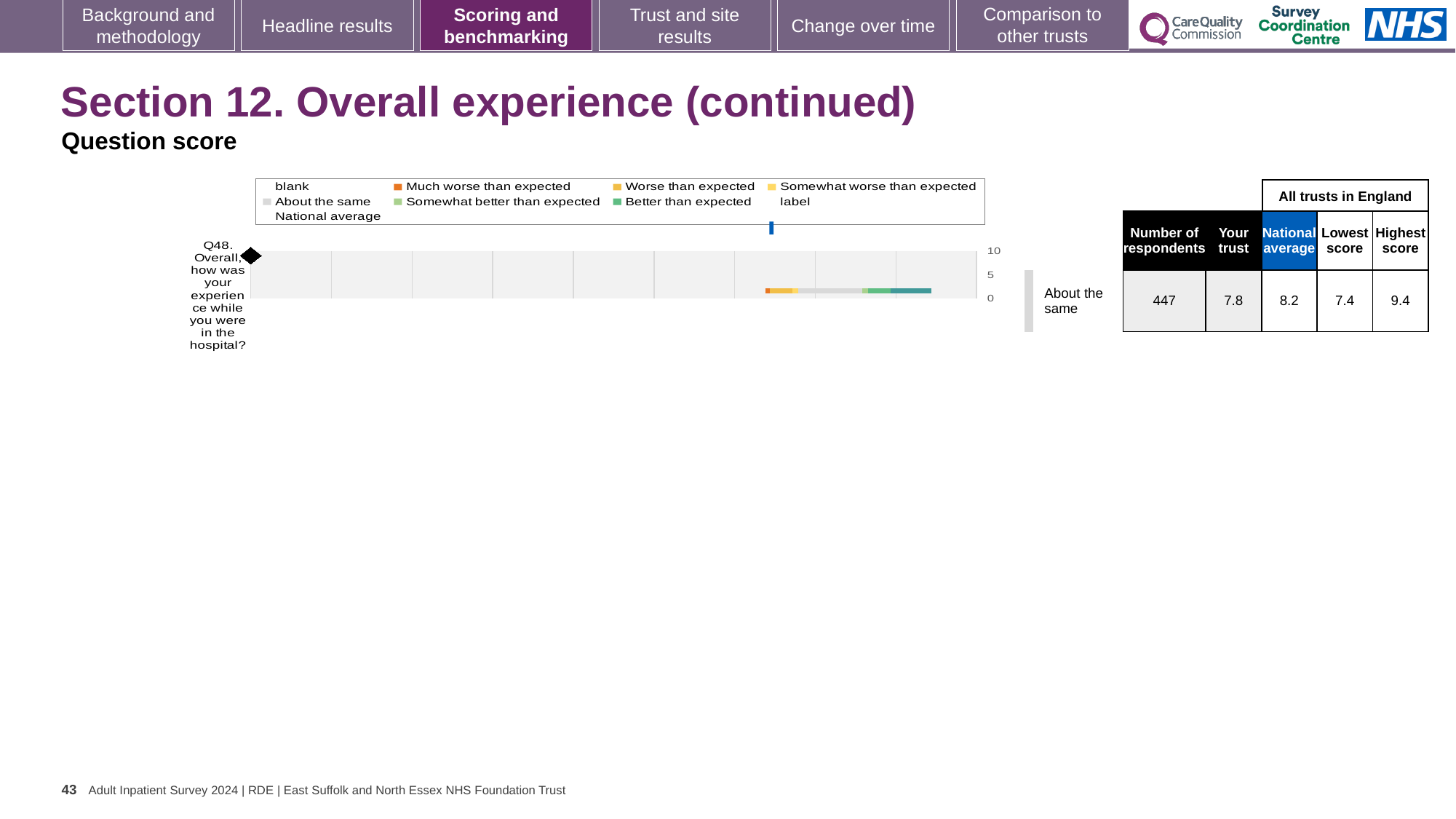
What is the lowest score among all trusts in England for Q48? 7.4 How many respondents answered Q48? 447 Which question is plotted on the chart? Q48. Overall, how was your experience while you were in the hospital? What is the highest value shown on the chart's axis? 10 What is the national average score for Q48? 8.2 Which benchmark band does the trust's Q48 score fall into? About the same What is the difference between the national average and the trust score for Q48? 0.4 How many questions (categories) are plotted on the chart? 1 What kind of chart is shown on the slide? bar chart What is the 'Your trust' score for Q48? 7.8 Which is larger for Q48, the trust score or the national average? national average What is the highest score among all trusts in England for Q48? 9.4